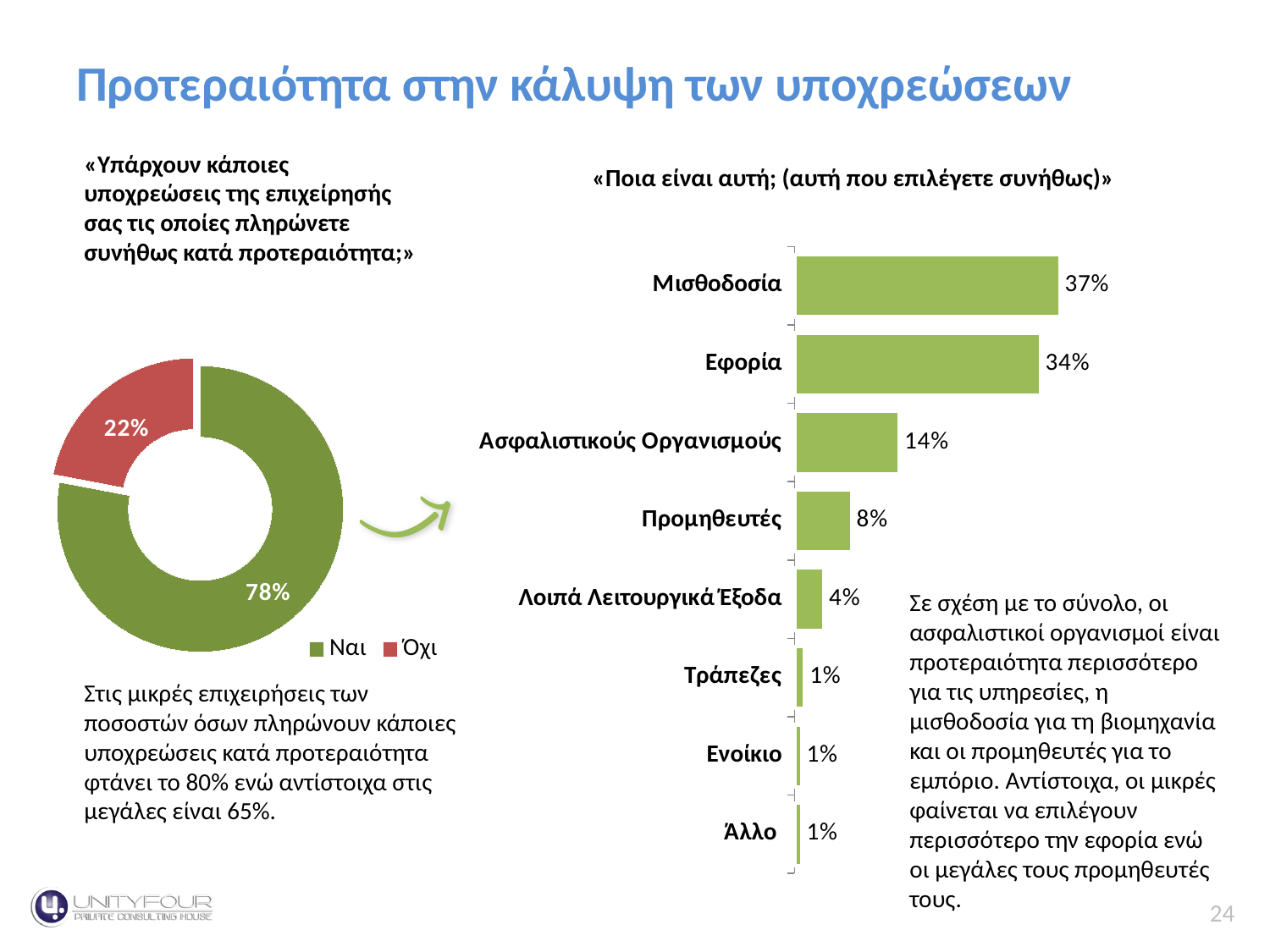
In the donut chart on the left, how many entries does the legend list? 2 What kind of chart is the chart on the right of the slide? Bar chart In the bar chart on the right, what is the value for Ασφαλιστικούς Οργανισμούς? 14% In the bar chart on the right, which is larger, the value for Προμηθευτές or the value for Λοιπά Λειτουργικά Έξοδα? Προμηθευτές In the bar chart on the right, what is the difference between the values for Μισθοδοσία and Εφορία? 3% In the bar chart on the right, which category has the highest value? Μισθοδοσία In the donut chart on the left, what percentage is shown for Όχι? 22% In the bar chart on the right, how many categories are shown? 8 In the bar chart on the right, what is the value for Μισθοδοσία? 37% In the donut chart on the left, what percentage is shown for Ναι? 78% In the bar chart on the right, what is the value for Προμηθευτές? 8% In the donut chart on the left, which slice is larger, Ναι or Όχι? Ναι